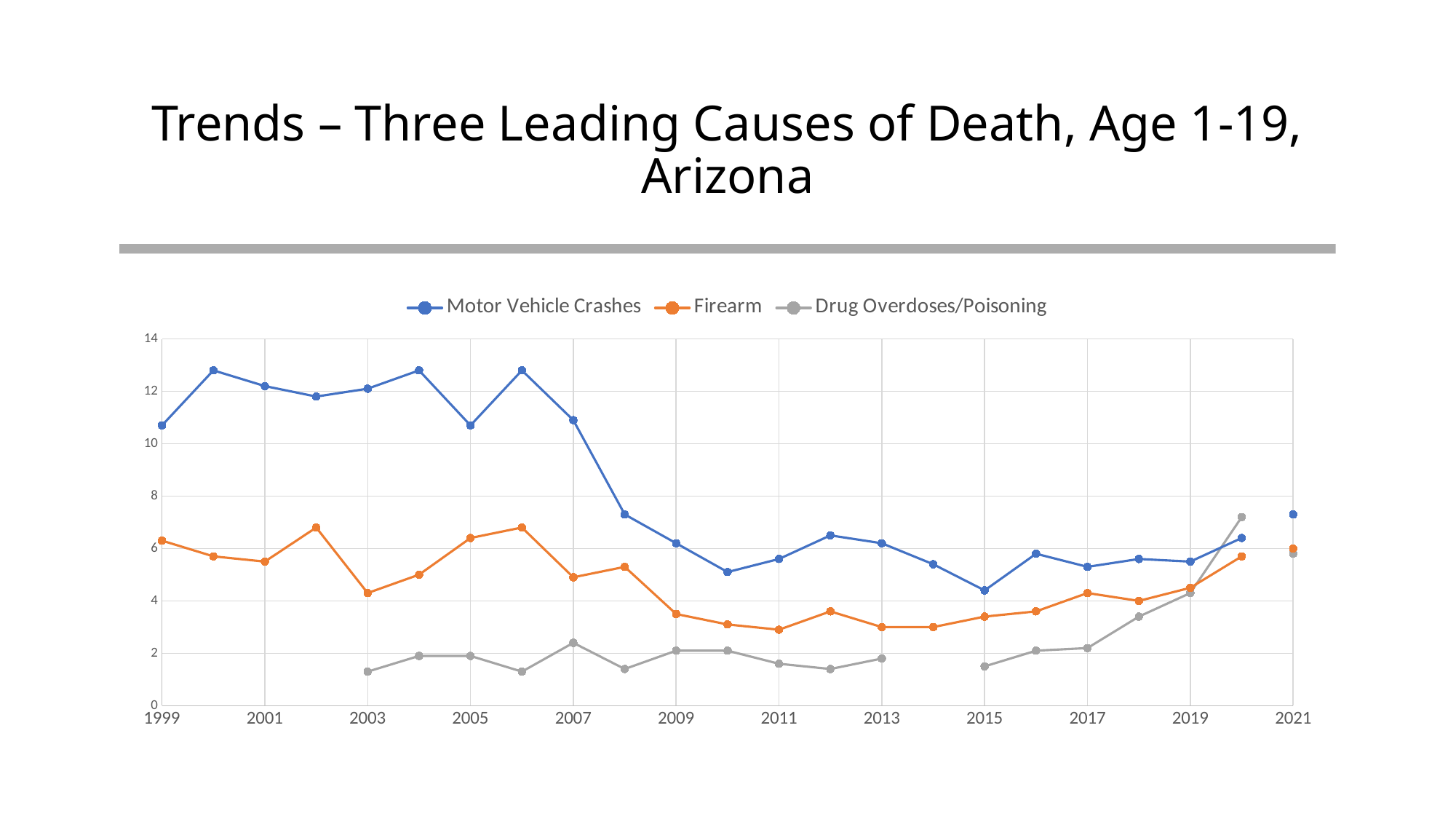
Which series is shown in orange? Firearm Is the value for Motor Vehicle Crashes in 2015 greater or less than 6? less How many series does the legend list? 3 What is the title of the chart on the slide? Trends – Three Leading Causes of Death, Age 1-19, Arizona What kind of chart is shown on the slide? Line chart Does the Motor Vehicle Crashes series overall rise or fall from 1999 to 2021? Fall In 2020, which is higher: Motor Vehicle Crashes or Drug Overdoses/Poisoning? Drug Overdoses/Poisoning Is the value for Firearm in 2009 greater or less than 4? less Is the value for Motor Vehicle Crashes in 2000 greater or less than 12? greater In which year is the Drug Overdoses/Poisoning series at its highest? 2020 In which year is the Motor Vehicle Crashes series at its lowest? 2015